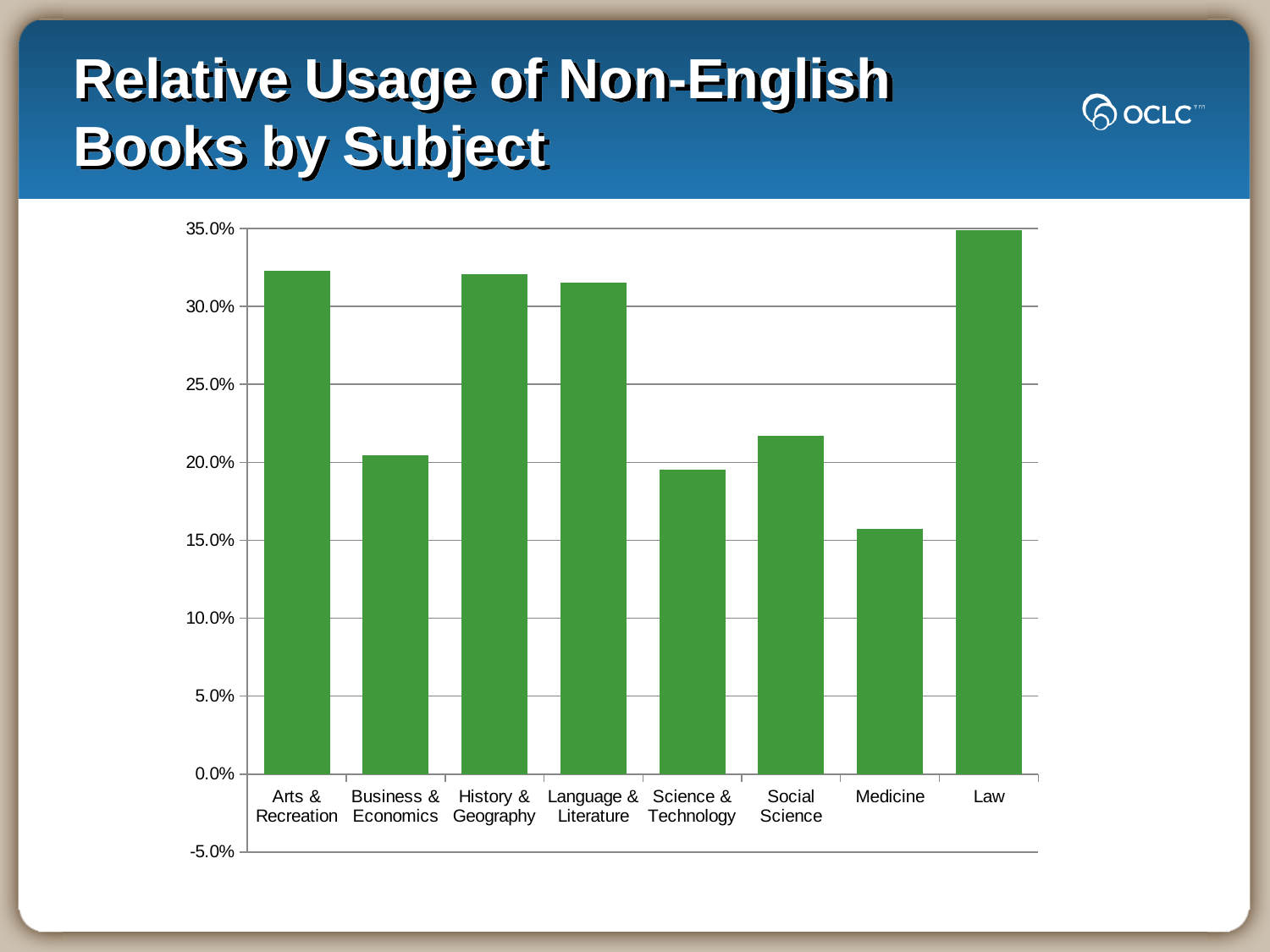
Is the value for Medicine greater or less than 20.0%? less Which is larger, the value for Law or the value for Business & Economics? Law Is the value for Arts & Recreation greater or less than 30.0%? greater Which is larger, the value for Medicine or the value for Science & Technology? Science & Technology Is the value for Law greater or less than 30.0%? greater Which subject has the highest relative usage of non-English books? Law Which subject has the lowest relative usage of non-English books? Medicine What is the title of the slide containing the chart? Relative Usage of Non-English Books by Subject How many subject categories are plotted in the chart? 8 What kind of chart is shown on the slide? bar chart